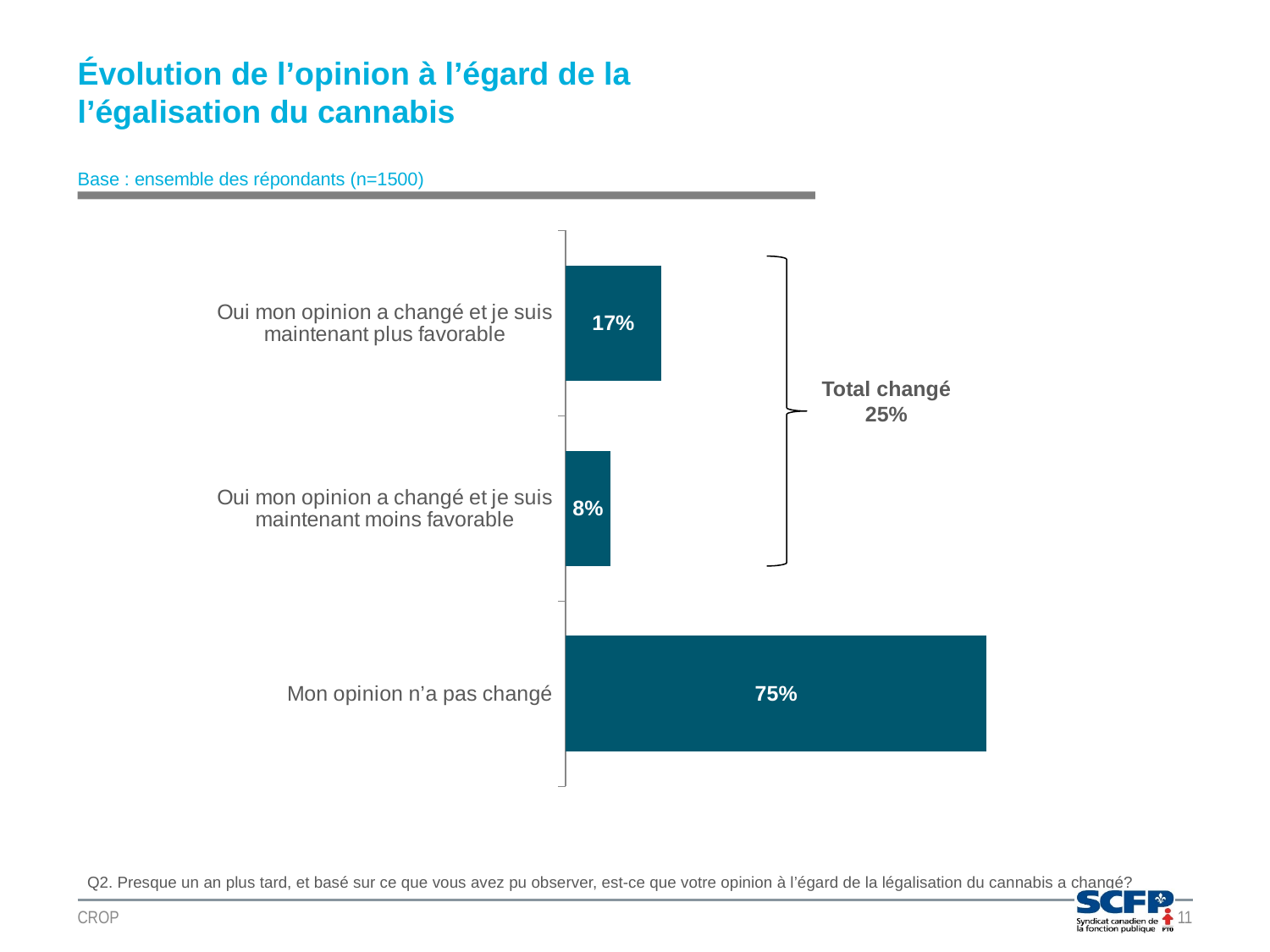
What percentage of respondents said their opinion changed and they are now less favourable ("moins favorable")? 8% What is the base (sample size) indicated on the slide? n=1500 What percentage of respondents said their opinion has not changed ("Mon opinion n'a pas changé")? 75% What kind of chart is shown on the slide? bar chart What is the difference between the "plus favorable" and "moins favorable" percentages? 9% How many categories are shown in the chart? 3 Which is larger: the "plus favorable" value or the "moins favorable" value? plus favorable What percentage of respondents said their opinion changed and they are now more favourable ("plus favorable")? 17% What is the combined total of respondents whose opinion changed ("Total changé")? 25% Which category has the lowest value? Oui mon opinion a changé et je suis maintenant moins favorable Which category has the highest value? Mon opinion n'a pas changé What is the difference between "Mon opinion n'a pas changé" and "plus favorable"? 58%